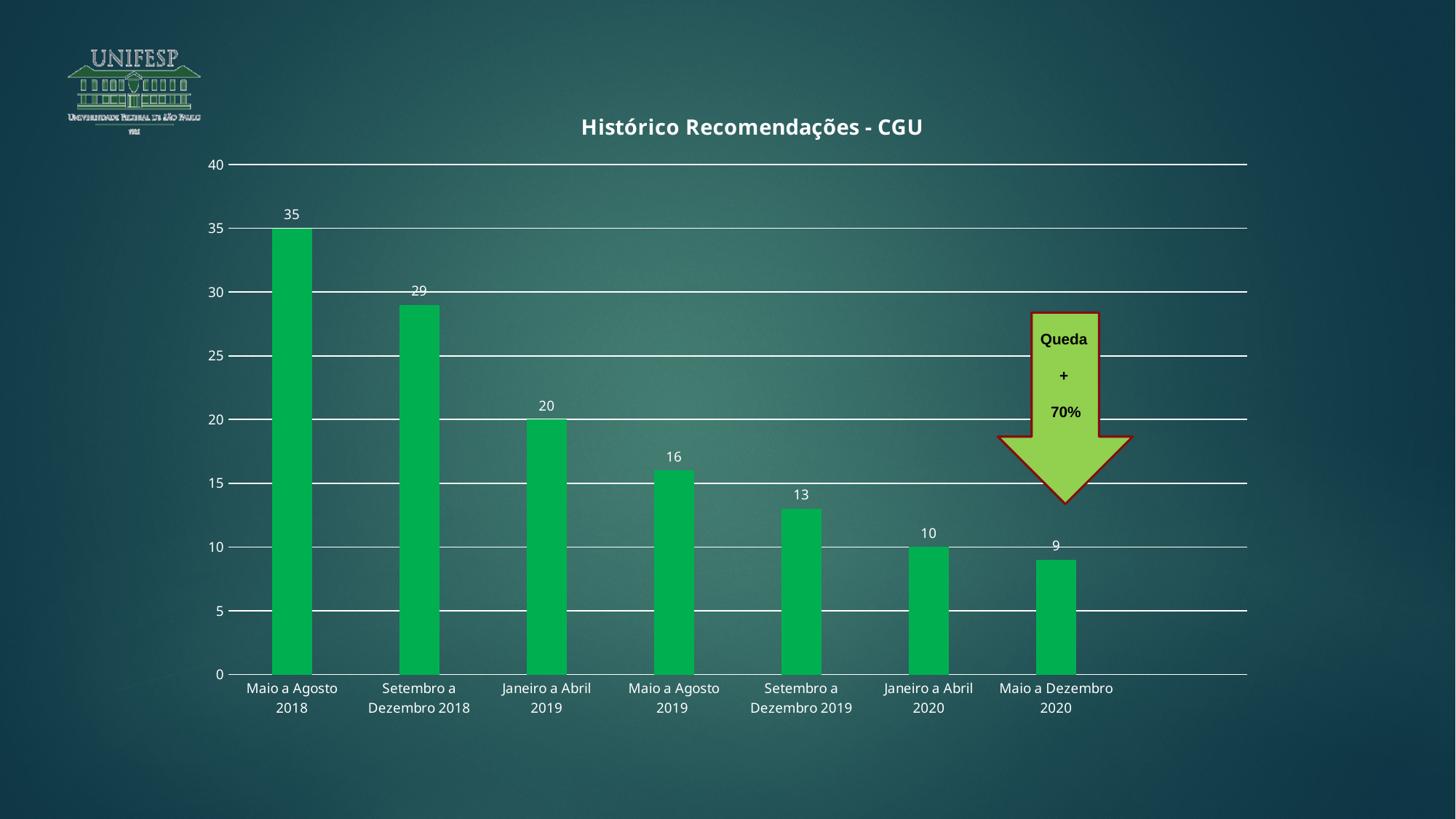
What is the difference between the values for Janeiro a Abril 2019 and Maio a Agosto 2019? 4 Which period has the highest value? Maio a Agosto 2018 Which period has the lowest value? Maio a Dezembro 2020 Which is larger, the value for Janeiro a Abril 2020 or the value for Maio a Dezembro 2020? Janeiro a Abril 2020 Is the value for Setembro a Dezembro 2018 greater or less than 25? greater What is the difference between the values for Maio a Agosto 2018 and Setembro a Dezembro 2018? 6 How many periods are shown on the x axis? 7 What is the value for Maio a Agosto 2018? 35 What is the value for Maio a Dezembro 2020? 9 What kind of chart is this? bar chart Do the values rise or fall from left to right along the x axis? fall What is the value for Setembro a Dezembro 2019? 13